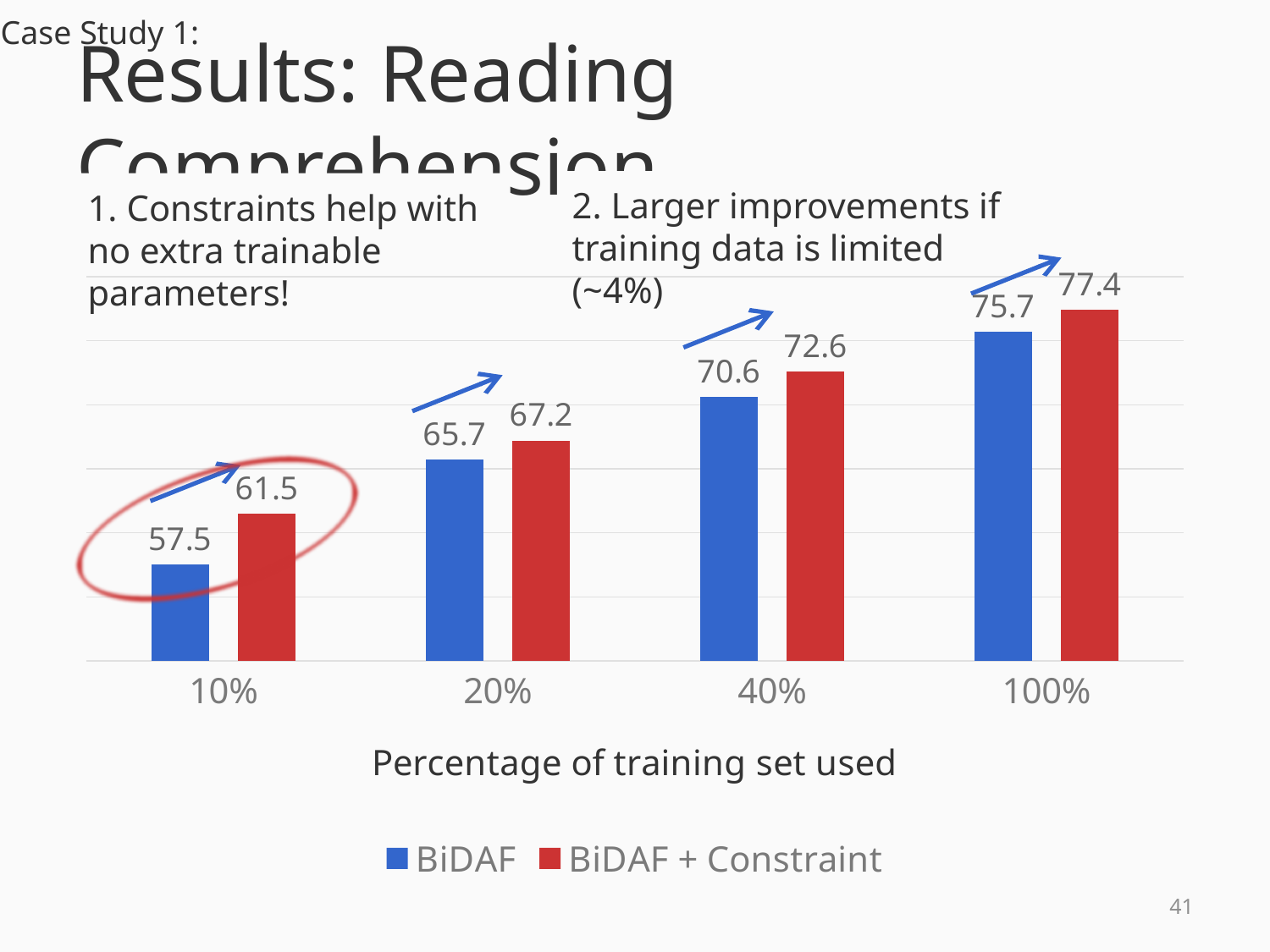
What is the value for BiDAF at 20% of the training set? 65.7 What is the value for BiDAF at 10% of the training set? 57.5 Which training-set percentage has the highest BiDAF + Constraint value? 100% How many training-set percentages are shown on the x axis? 4 What is the value for BiDAF + Constraint at 100% of the training set? 77.4 Which training-set percentage has the lowest BiDAF value? 10% At 20% of the training set, which is larger: BiDAF or BiDAF + Constraint? BiDAF + Constraint What is the difference between BiDAF + Constraint and BiDAF at 10% of the training set? 4.0 What is the value for BiDAF + Constraint at 40% of the training set? 72.6 What is the difference between BiDAF + Constraint and BiDAF at 100% of the training set? 1.7 What kind of chart is shown on the slide? Bar chart How many series does the legend list? 2